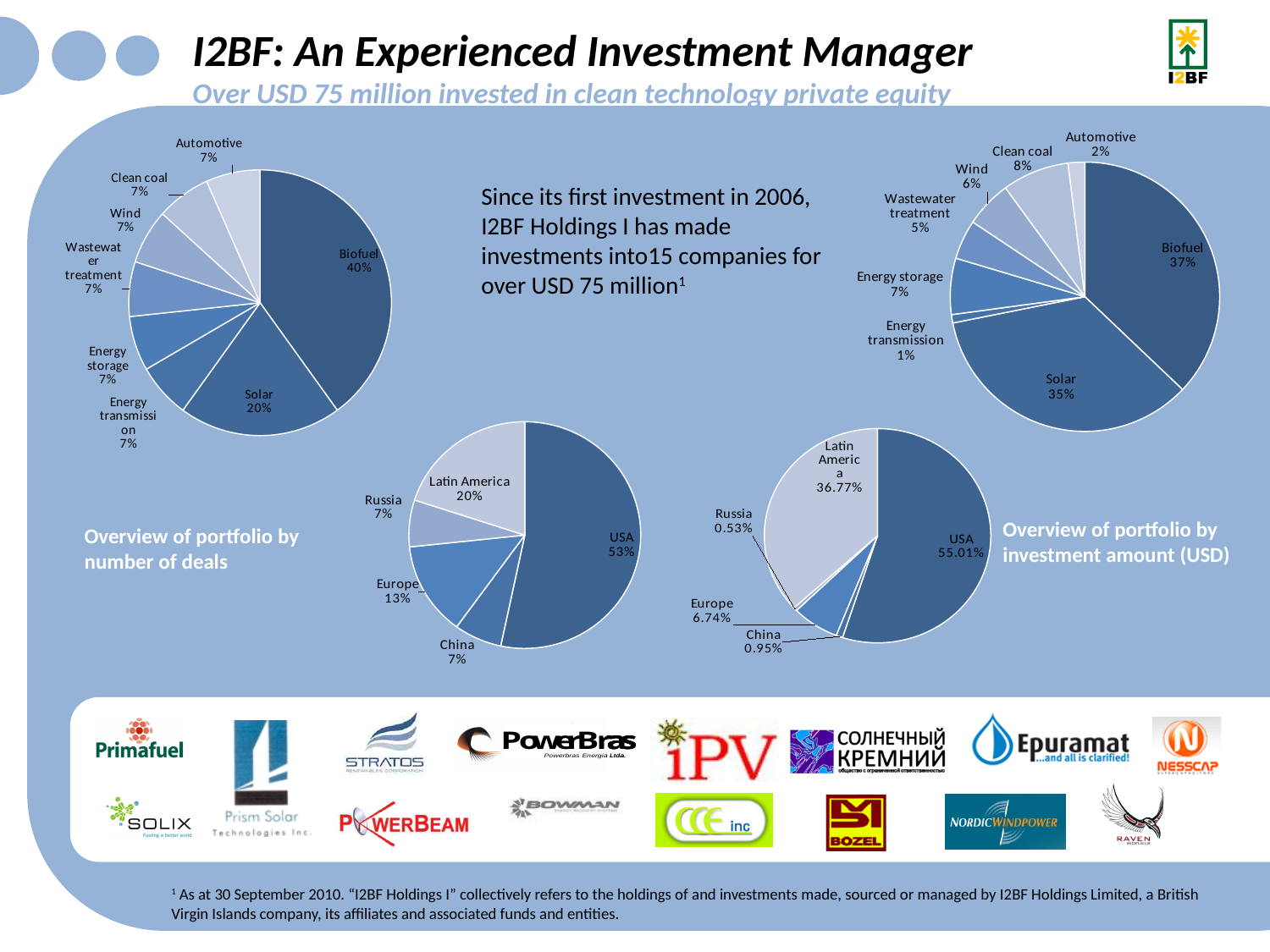
In the bottom-right pie chart (portfolio by investment amount, by region), what share does Russia have? 0.53% In the top-right pie chart (sectors by investment amount), what share does Solar have? 35% In the bottom-right pie chart (portfolio by investment amount, by region), which is larger, Europe or China? Europe In the top-right pie chart (sectors by investment amount), which sector has the smallest share? Energy transmission In the top-right pie chart (sectors by investment amount), which is larger, Clean coal or Wind? Clean coal What type of chart is used for the bottom-right chart (portfolio by investment amount)? Pie chart In the top-left pie chart (sectors by number of deals), which sector has the largest share? Biofuel In the bottom-left pie chart (portfolio by number of deals, by region), what share does Latin America have? 20% In the bottom-left pie chart (portfolio by number of deals, by region), which region has the largest share? USA How many slices does the top-left pie chart (sectors by number of deals) have? 8 In the top-left pie chart (sectors by number of deals), what share does Biofuel have? 40% In the top-right pie chart (sectors by investment amount), what is the difference between the Biofuel and Solar shares? 2%